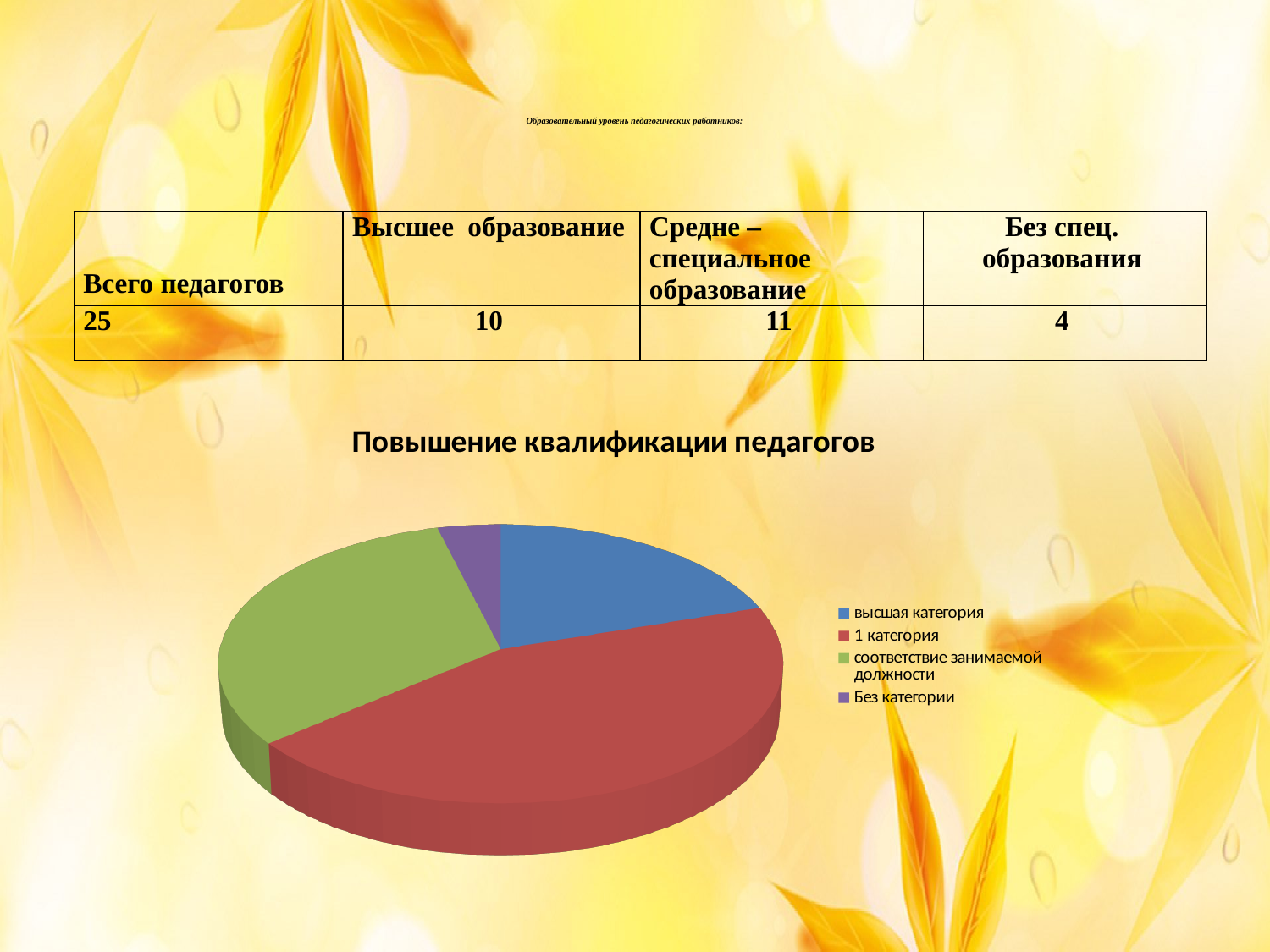
How many slices does the pie chart have? 4 What colour represents "1 категория" in the pie chart? red Which category has the smallest slice in the pie chart? Без категории In the pie chart, which slice is larger: "высшая категория" or "Без категории"? высшая категория Which category has the largest slice in the pie chart? 1 категория In the pie chart, which slice is larger: "соответствие занимаемой должности" or "высшая категория"? соответствие занимаемой должности What kind of chart is shown under the title "Повышение квалификации педагогов"? pie chart How many categories does the legend of the pie chart list? 4 In the pie chart, which slice is larger: "1 категория" or "соответствие занимаемой должности"? 1 категория What is the title of the pie chart? Повышение квалификации педагогов